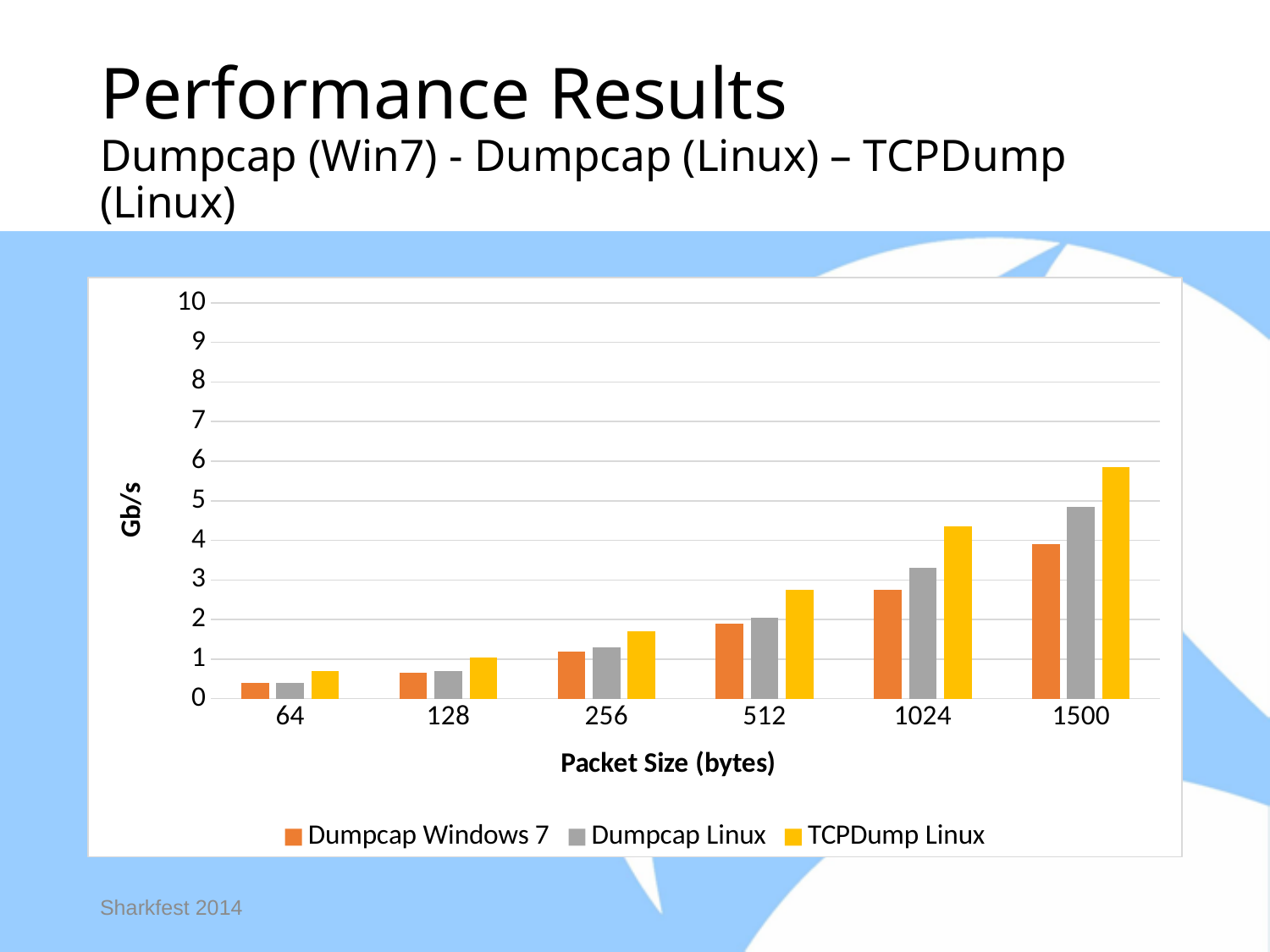
How many packet size categories are shown on the x axis? 6 At which packet size does TCPDump Linux reach its highest value? 1500 At which packet size is the Dumpcap Windows 7 value lowest? 64 Is the value for TCPDump Linux at packet size 1500 greater or less than 5? greater What kind of chart is shown on the slide? bar chart At packet size 1500, which is larger: Dumpcap Windows 7 or TCPDump Linux? TCPDump Linux How many series does the legend list? 3 Is the value for Dumpcap Windows 7 at packet size 1024 greater or less than 3? less Do the values for each series rise or fall as packet size increases along the x axis? rise Is the value for Dumpcap Linux at packet size 1500 greater or less than 4? greater